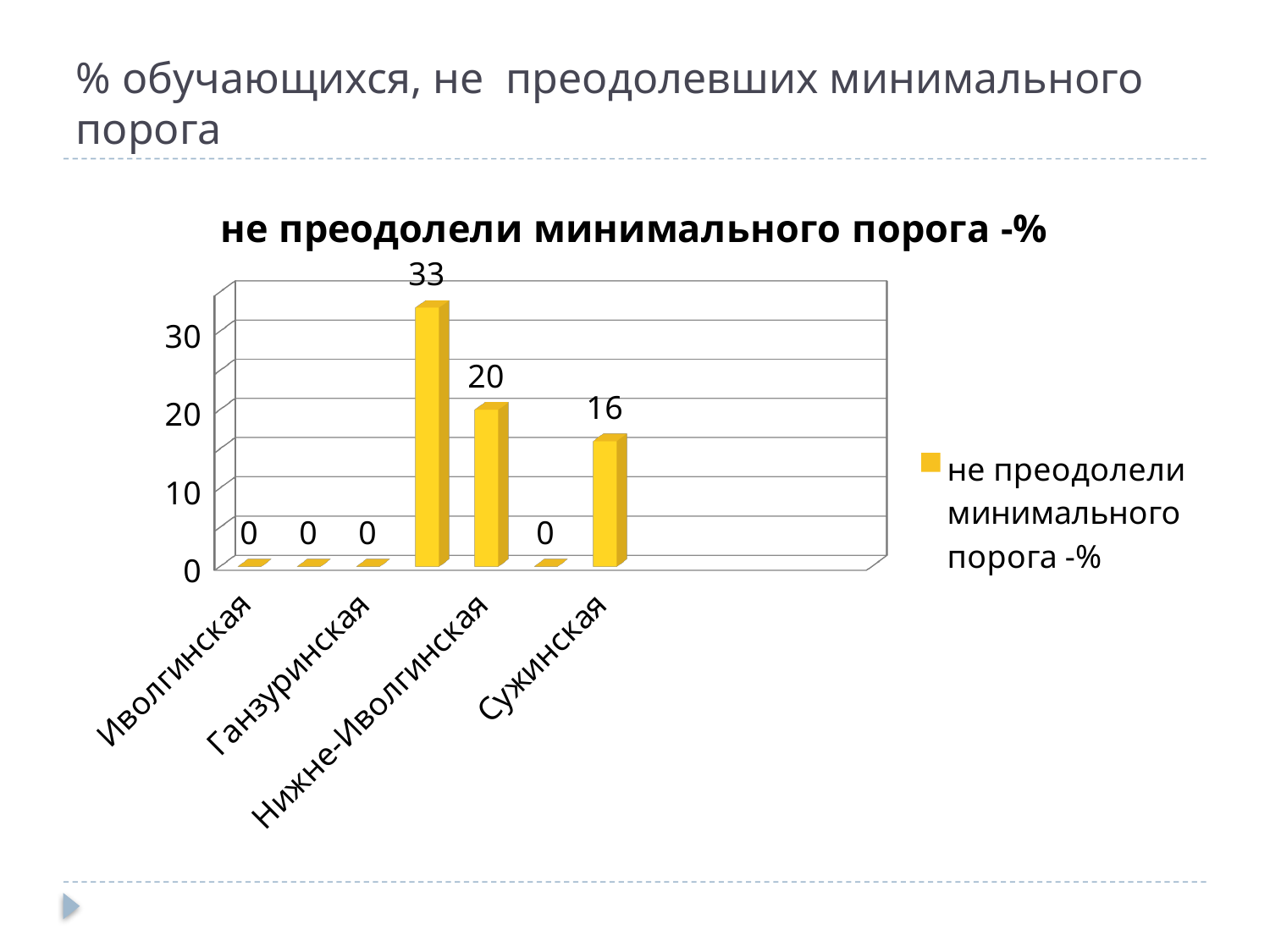
What is the title of the chart? не преодолели минимального порога -% What is the value for Нижне-Иволгинская? 20 What is the difference between the values for Нижне-Иволгинская and Сужинская? 4 What is the value for Сужинская? 16 Which is larger, the value for Нижне-Иволгинская or the value for Сужинская? Нижне-Иволгинская Is the value for Сужинская greater or less than 10? greater What is the highest value shown by any bar in the chart? 33 How many series does the legend list? 1 What is the value for Ганзуринская? 0 What kind of chart is shown on the slide? bar chart What is the value for Иволгинская? 0 How many bars are plotted in the chart? 7